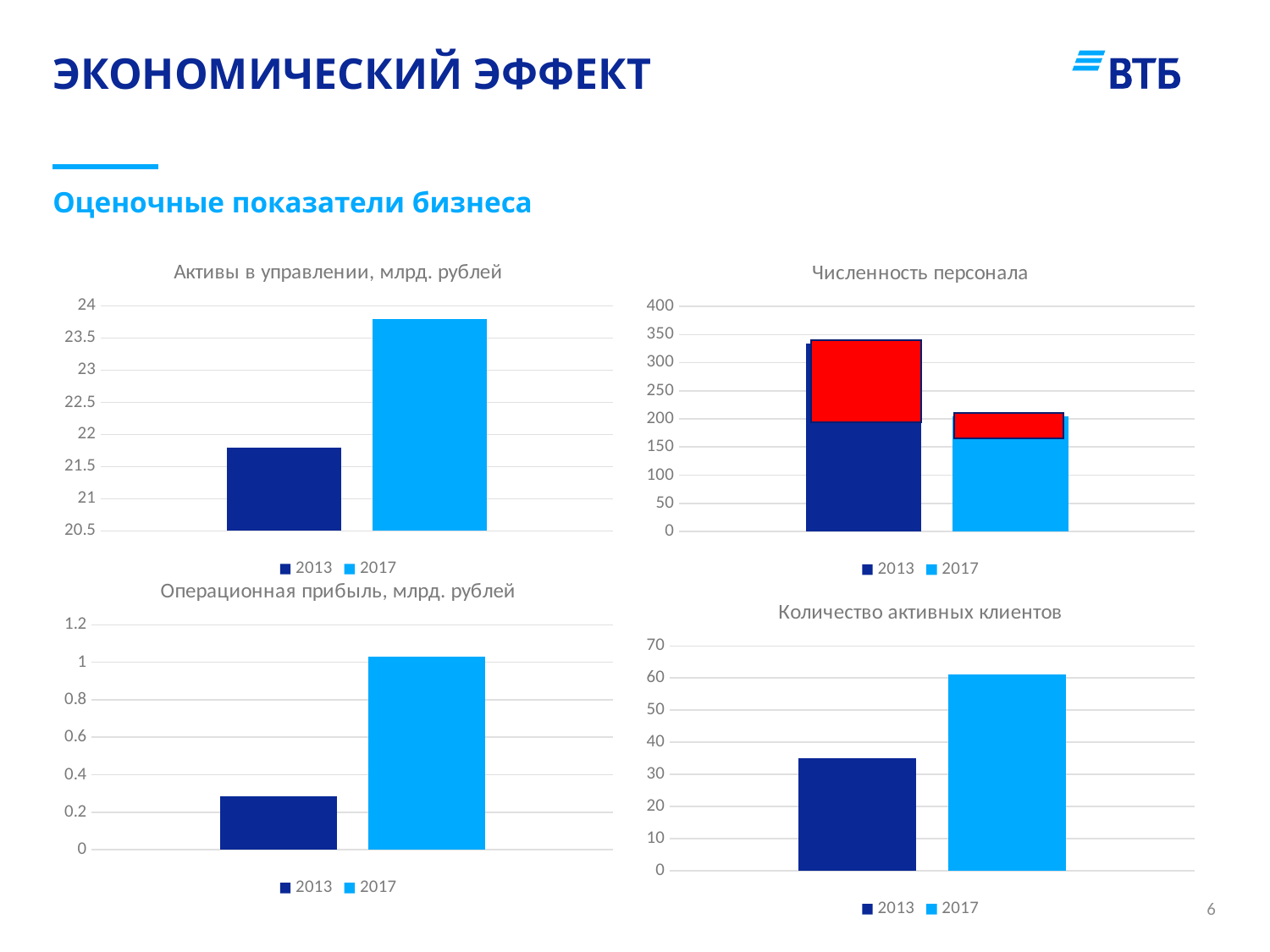
In the chart titled 'Численность персонала', is the value for 2013 greater or less than 300? greater In the chart titled 'Активы в управлении, млрд. рублей', is the value for 2017 greater or less than 23.5? greater In the chart titled 'Операционная прибыль, млрд. рублей', is the value for 2013 greater or less than 0.4? less What kind of chart is the chart titled 'Операционная прибыль, млрд. рублей'? bar chart In the chart titled 'Численность персонала', which year has the larger value, 2013 or 2017? 2013 In the chart titled 'Активы в управлении, млрд. рублей', which year has the higher value, 2013 or 2017? 2017 How many series does the legend list in the chart titled 'Количество активных клиентов'? 2